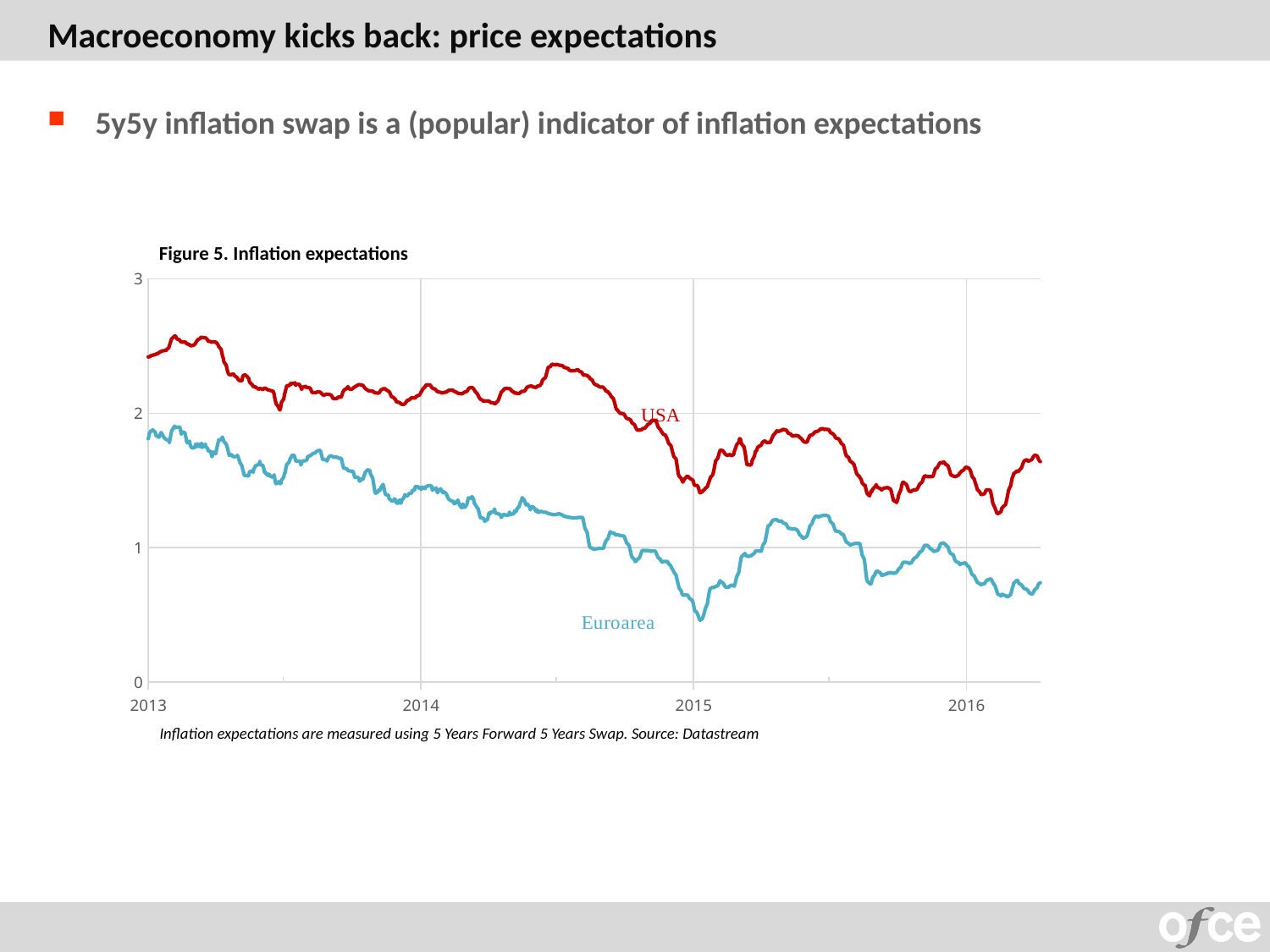
Which colour is used for the USA line in the chart? red Which of the two series lies above the other across the whole period shown? USA What kind of chart is Figure 5. Inflation expectations? line chart Is the value for USA at the start of 2016 greater or less than 1? greater Is the value for Euroarea at the start of 2015 greater or less than 1? less How many series are plotted in Figure 5. Inflation expectations? 2 What is the title of the chart on the slide? Figure 5. Inflation expectations Which series is higher at the start of 2015, USA or Euroarea? USA How many year labels are shown on the x axis of the chart? 4 Does the Euroarea series generally rise or fall from 2013 to 2016? fall Is the value for Euroarea at the start of 2013 greater or less than 2? less